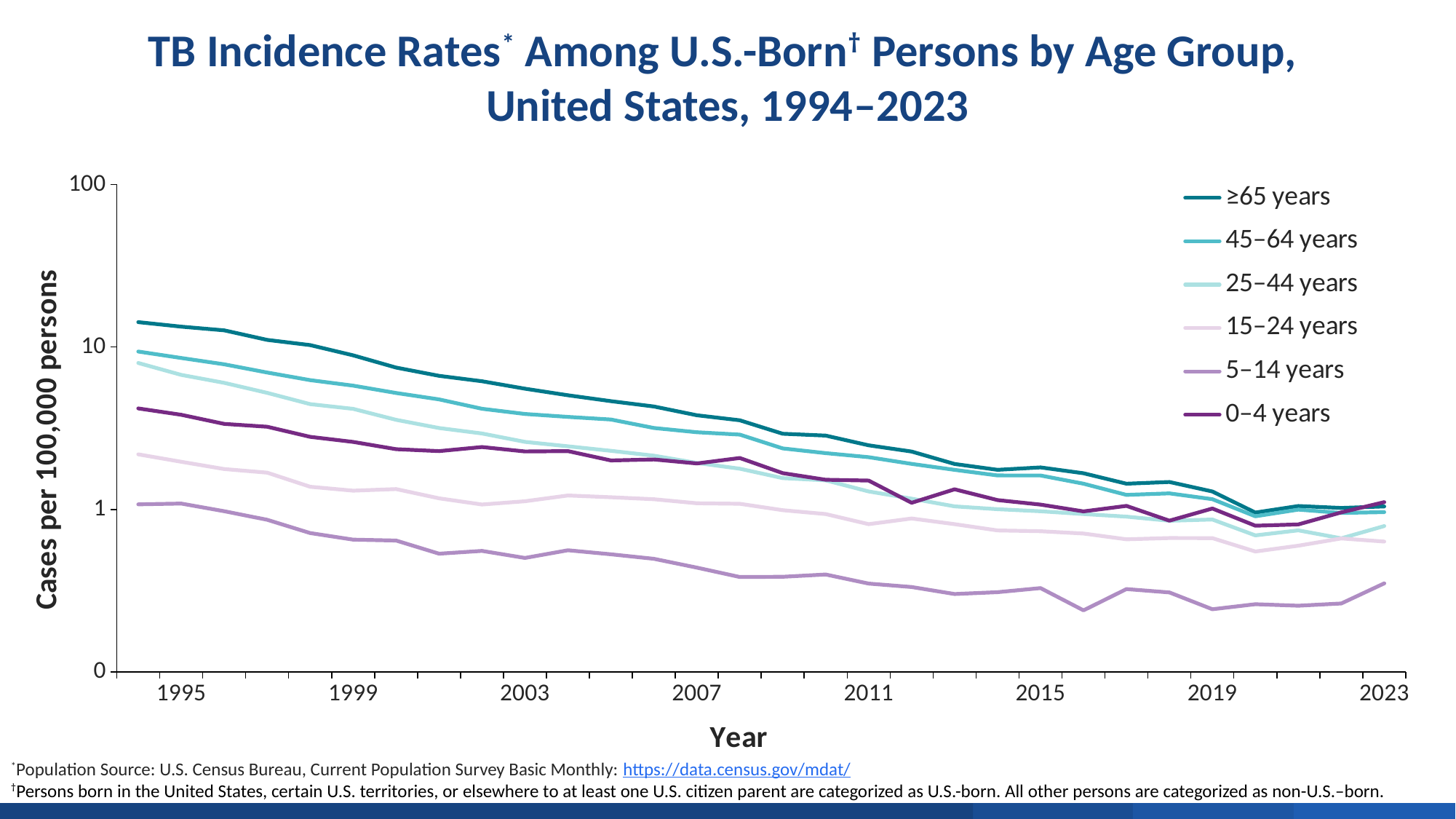
What is the label of the horizontal axis? Year Is the value for the ≥65 years group in 1995 greater or less than 10? greater Do the TB incidence rates for the ≥65 years group rise or fall from 1994 to 2023? fall How many age-group series does the legend list? 6 In 1995, which has the larger TB incidence rate: the 0–4 years group or the 15–24 years group? 0–4 years Is the value for the 5–14 years group in 2023 greater or less than 1? less Is the value for the 15–24 years group in 2023 greater or less than 1? less What is the label of the vertical axis? Cases per 100,000 persons Which age group has the highest TB incidence rate in 1995? ≥65 years Which age group has the lowest TB incidence rate in 2023? 5–14 years What kind of chart is shown on the slide? line chart